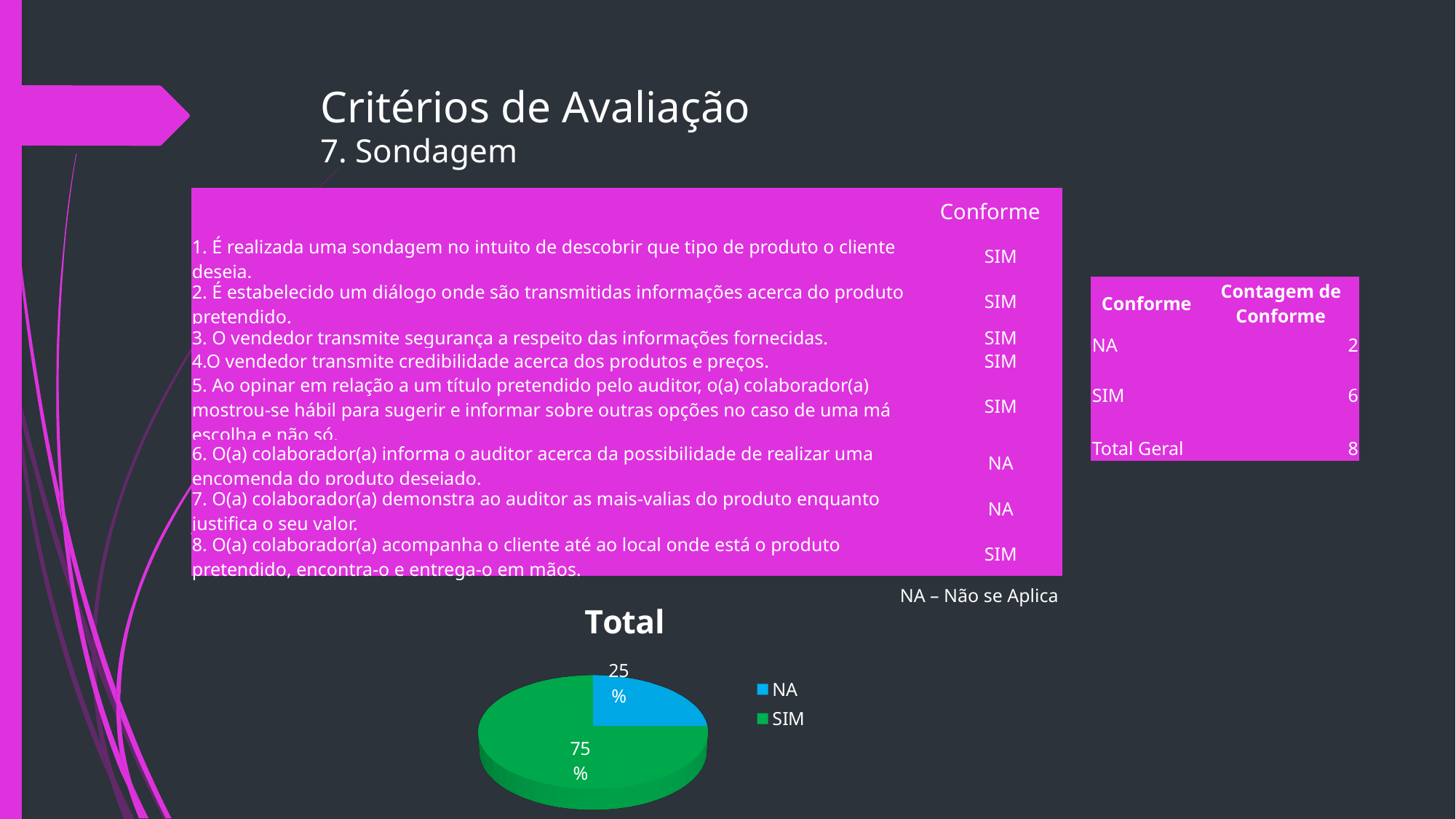
What kind of chart is shown under the title "Total"? pie chart What is the difference in percentage points between the SIM slice and the NA slice in the pie chart? 50 What colour is the SIM slice in the pie chart? green What is the title of the pie chart? Total How many slices does the pie chart have? 2 How many entries does the legend of the pie chart list? 2 What share of the pie chart does NA represent? 25% What share of the pie chart does SIM represent? 75% In the pie chart, which is larger, the NA slice or the SIM slice? SIM Which slice of the pie chart is the largest? SIM Which slice of the pie chart is the smallest? NA